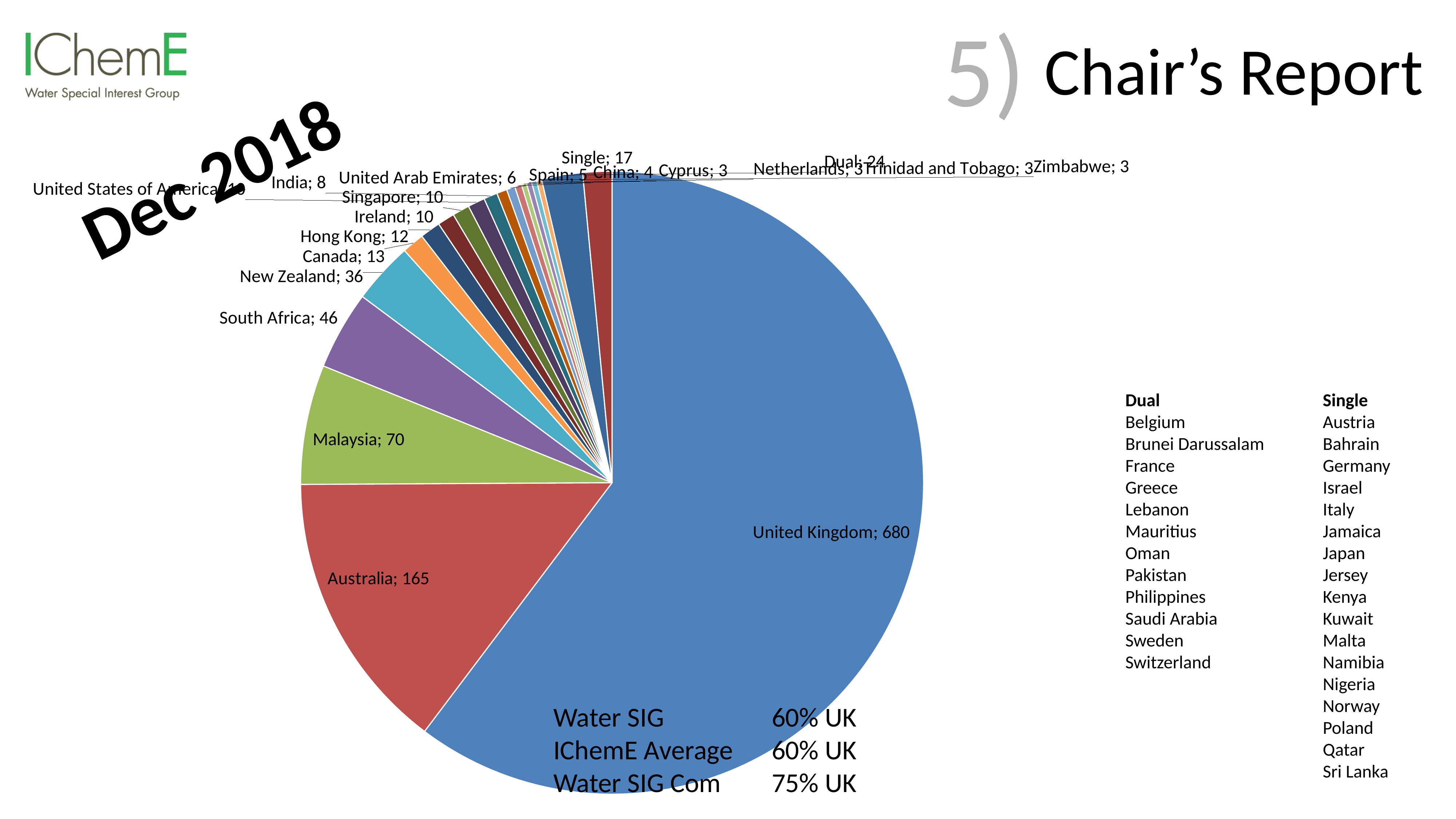
What is the difference between the values for Malaysia and South Africa? 24 What percentage of Water SIG members are UK-based according to the text on the slide? 60% UK What is the value for New Zealand in the pie chart? 36 Which is larger, the value for Canada or the value for Hong Kong? Canada What is the value for United Kingdom in the pie chart? 680 What is the value for South Africa in the pie chart? 46 What is the value for Dual in the pie chart? 24 Which category has the largest slice in the pie chart? United Kingdom What type of chart is shown on the slide? Pie chart What is the value for Malaysia in the pie chart? 70 What is the value for Australia in the pie chart? 165 What is the difference between the values for United Kingdom and Australia? 515